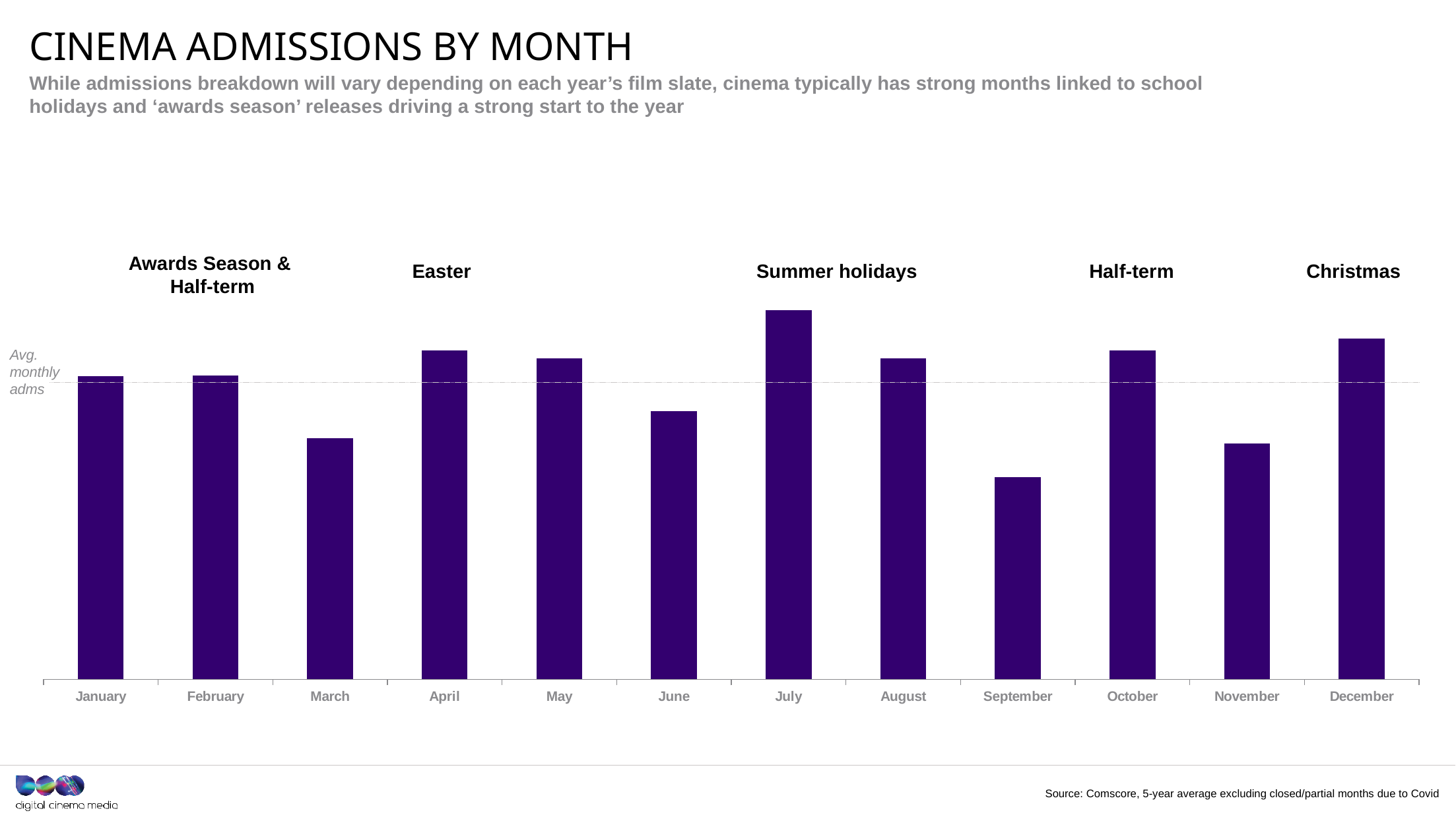
Which month has higher admissions, July or December? July Is the value for December greater or less than the average monthly admissions line? greater Which month has higher admissions, June or March? June Which month has the lowest average admissions? September Which month has higher admissions, November or September? November From July to September, do the values rise or fall? fall Is the value for September greater or less than the average monthly admissions line? less What label is shown above the July and August bars? Summer holidays What is the title of the chart? CINEMA ADMISSIONS BY MONTH Which month has the highest average admissions? July What kind of chart is shown on the slide? bar chart How many months are plotted on the chart? 12